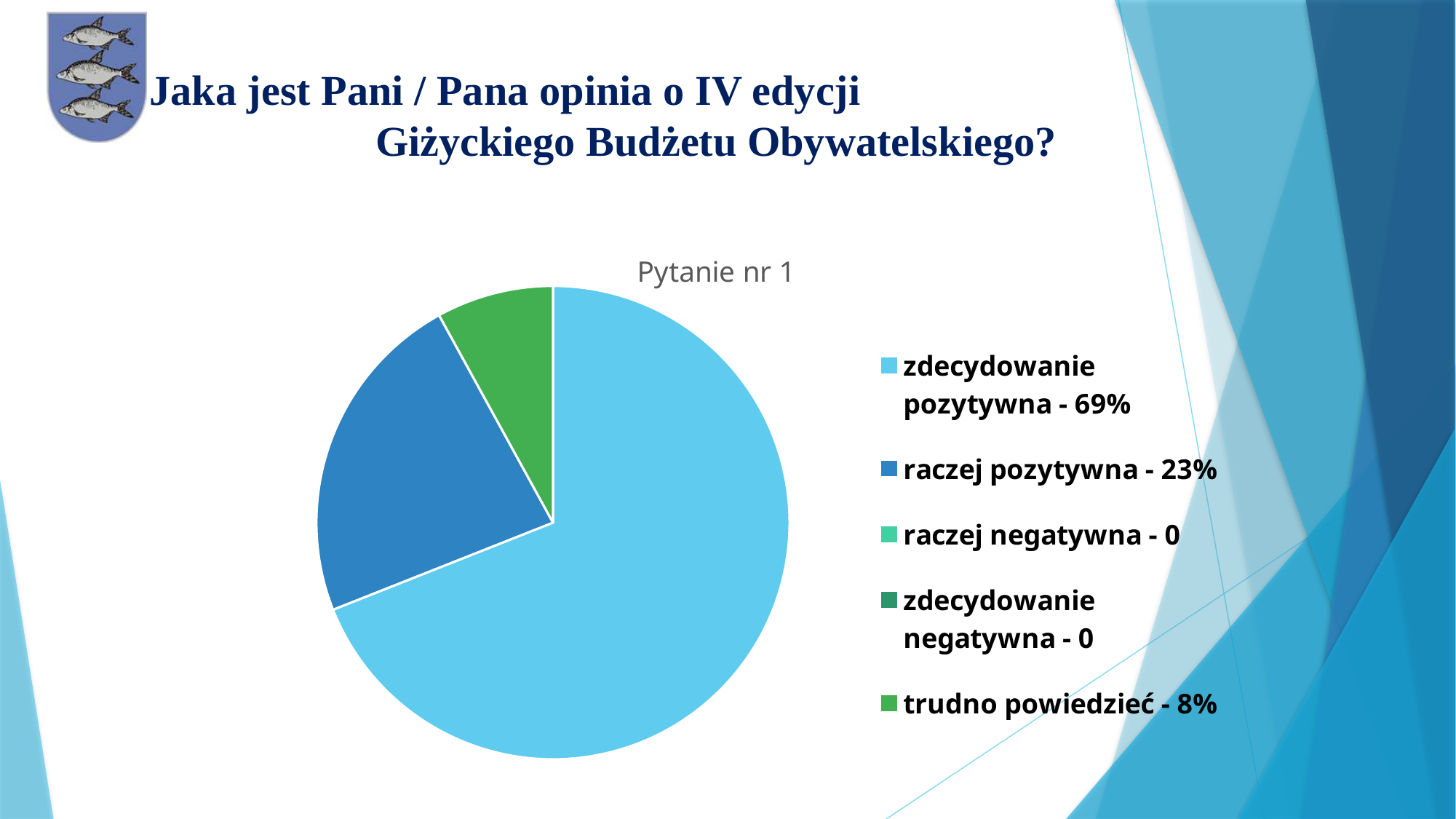
What kind of chart is shown on the slide? pie chart Which response category has the largest share of the pie? zdecydowanie pozytywna Which of the categories with a visible slice has the smallest share? trudno powiedzieć What share of responses is 'raczej pozytywna'? 23% What colour is the slice for 'trudno powiedzieć'? green What value is given for 'raczej negatywna'? 0 What share of responses is 'trudno powiedzieć'? 8% How many categories does the legend list? 5 Which is larger: the share for 'raczej pozytywna' or for 'trudno powiedzieć'? raczej pozytywna What is the title of the chart? Pytanie nr 1 What share of responses is 'zdecydowanie pozytywna'? 69% What is the difference between the shares of 'zdecydowanie pozytywna' and 'raczej pozytywna'? 46%